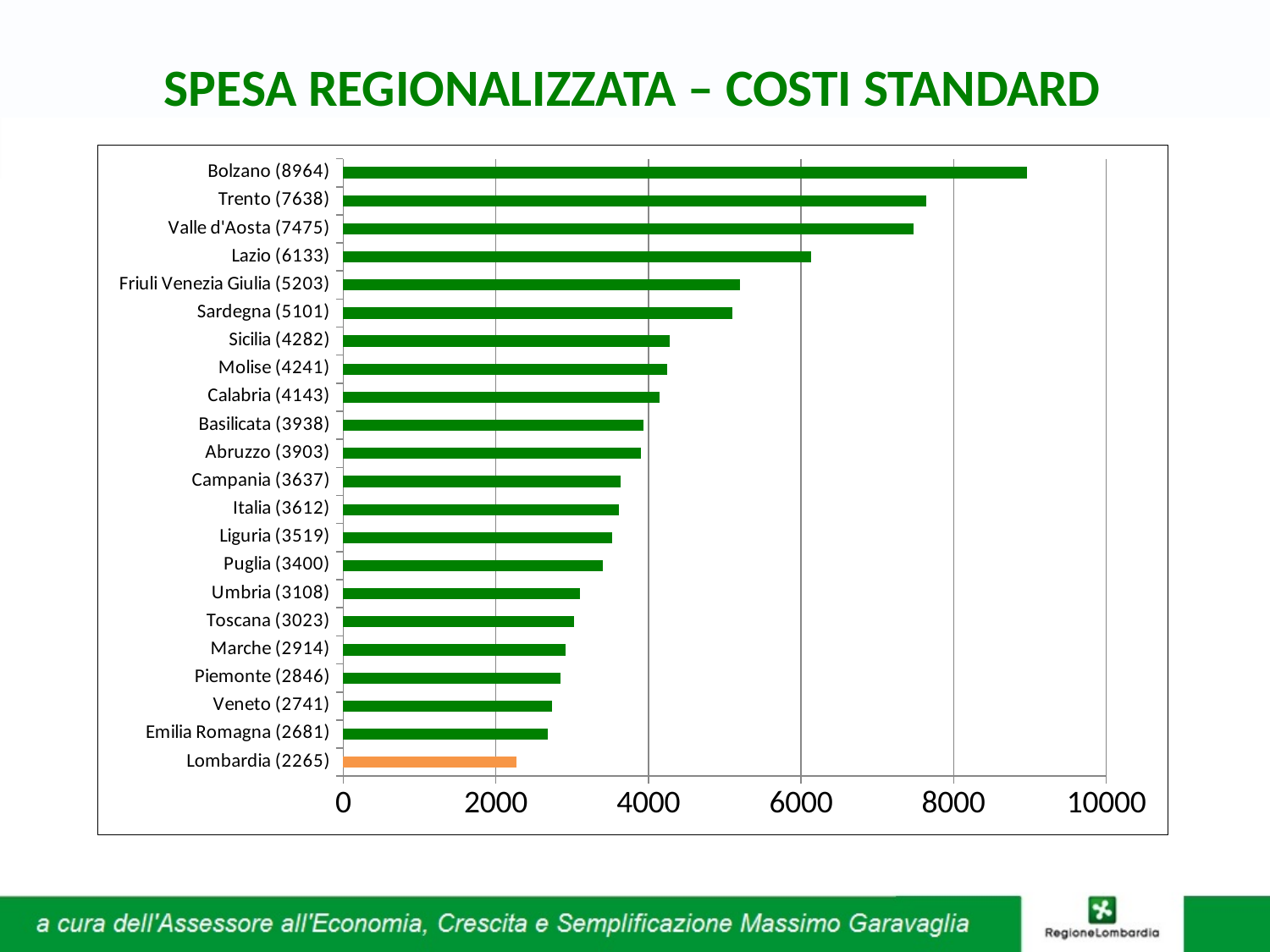
What is the value for Lombardia? 2265 Which has a larger value, Lazio or Sardegna? Lazio Which region has the highest value? Bolzano What is the difference between the values for Trento and Valle d'Aosta? 163 Is the value for Friuli Venezia Giulia greater or less than 4000? greater What is the value for Bolzano? 8964 Which region has the lowest value? Lombardia What is the difference between the values for Bolzano and Lombardia? 6699 What kind of chart is shown on the slide? Bar chart What is the value for Italia? 3612 How many regions are shown in the chart? 22 Which bar is coloured differently (orange) from the others? Lombardia